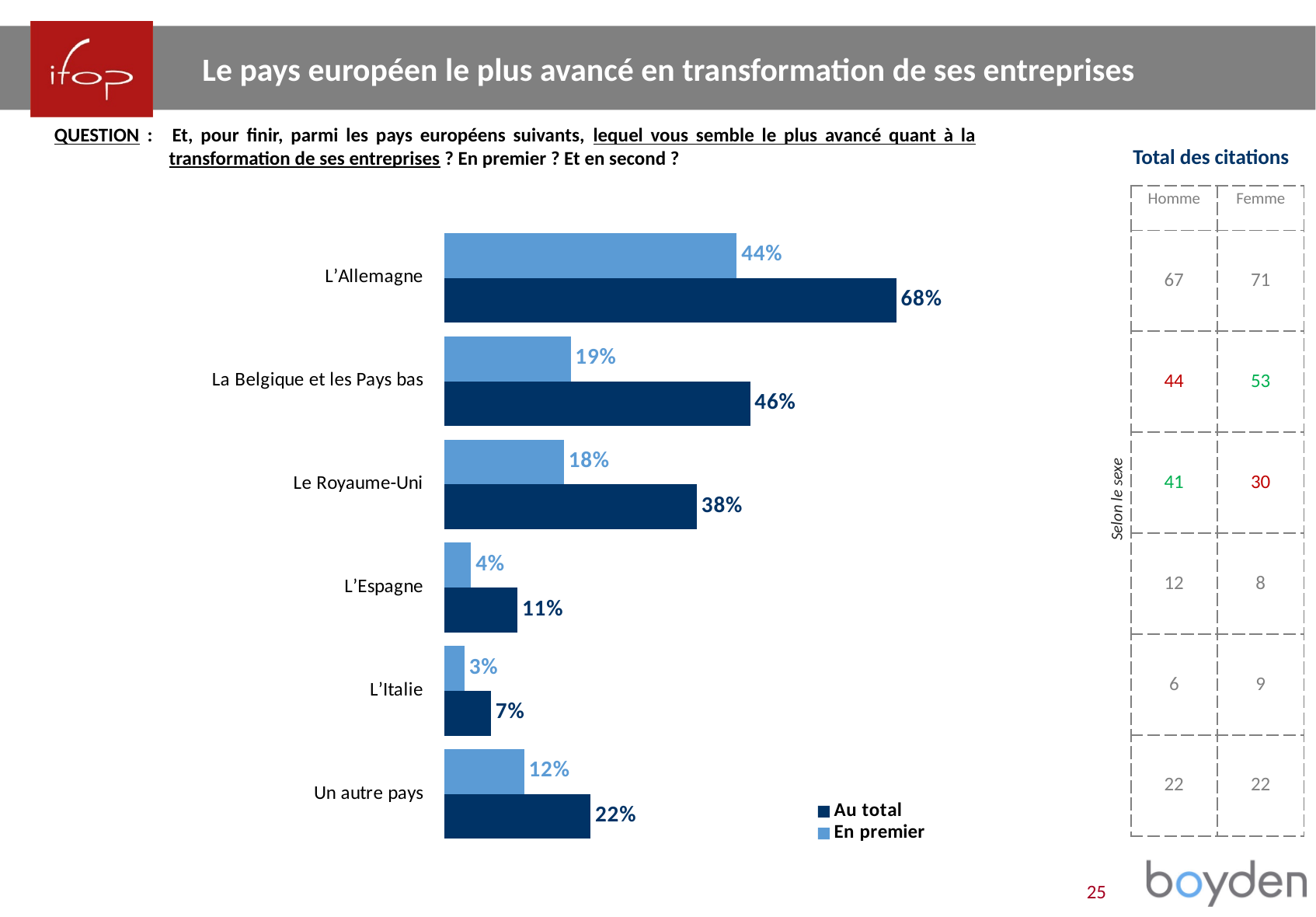
Which category has the lowest 'En premier' value? L'Italie How many categories are shown in the bar chart? 6 Which is larger: the 'Au total' value for L'Espagne or the 'Au total' value for Un autre pays? Un autre pays What is the 'En premier' value for L'Italie? 3% What is the 'Au total' value for Le Royaume-Uni? 38% Which country has the highest 'Au total' value? L'Allemagne What is the 'Au total' value for L'Allemagne? 68% What kind of chart is shown on the slide? Bar chart What is the 'En premier' value for La Belgique et les Pays bas? 19% What is the difference between the 'Au total' and 'En premier' values for L'Allemagne? 24% How many series does the legend list? 2 What are the two series named in the legend? Au total and En premier